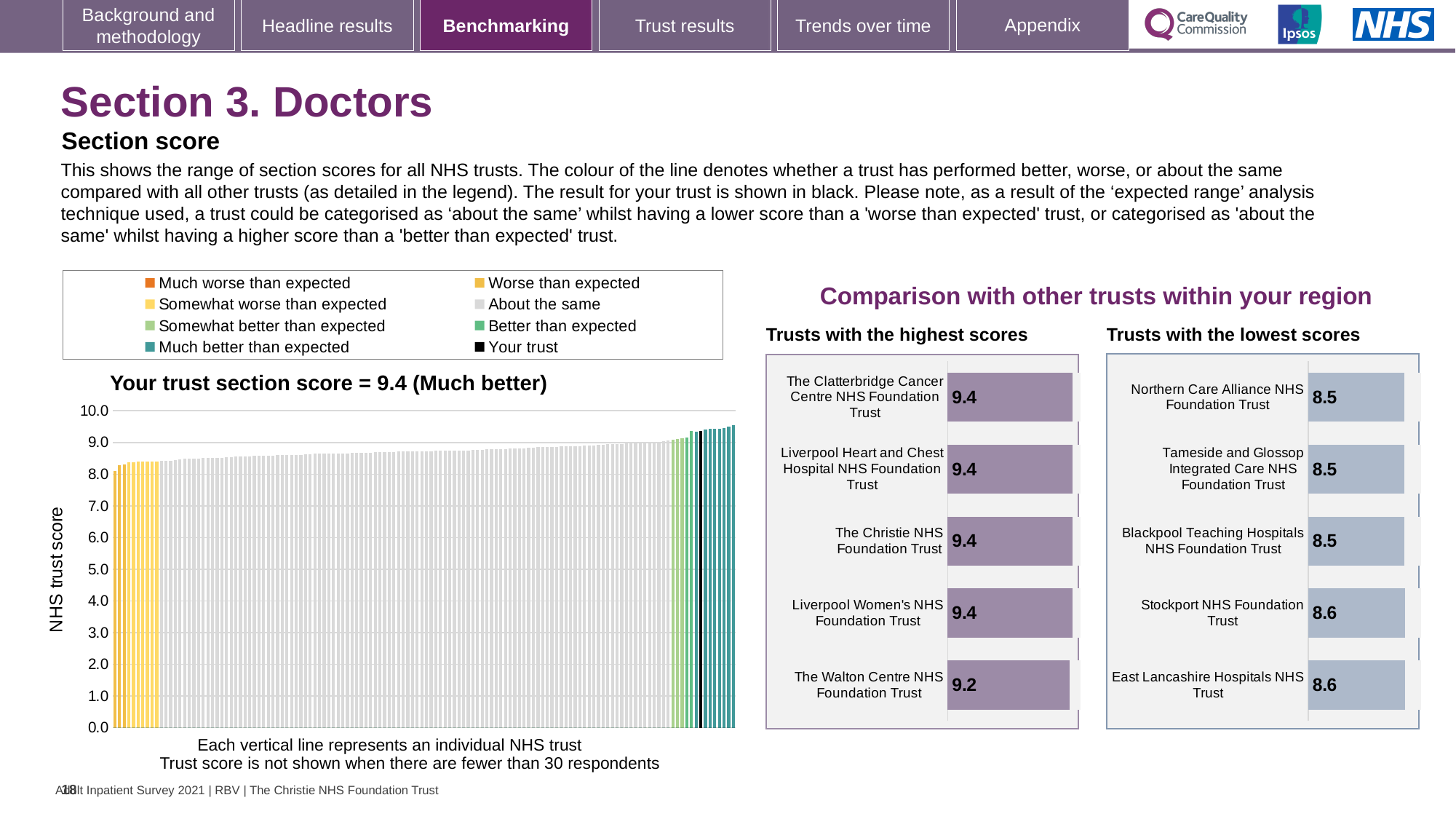
On the 'Trusts with the highest scores' chart, what is the difference between the score for The Clatterbridge Cancer Centre NHS Foundation Trust and The Walton Centre NHS Foundation Trust? 0.2 On the 'Trusts with the lowest scores' chart, what is the difference between the score for East Lancashire Hospitals NHS Trust and Tameside and Glossop Integrated Care NHS Foundation Trust? 0.1 On the 'Trusts with the highest scores' chart, what is the score for The Walton Centre NHS Foundation Trust? 9.2 On the 'Your trust section score' chart, do the trust scores rise or fall from left to right along the x axis? rise On the 'Your trust section score' chart, how many entries does the legend list? 8 On the 'Trusts with the highest scores' chart, how many trusts are shown? 5 On the 'Trusts with the lowest scores' chart, what is the score for Blackpool Teaching Hospitals NHS Foundation Trust? 8.5 On the 'Your trust section score' chart, is the value for your trust greater or less than 9.0? greater On the 'Your trust section score' chart, what kind of chart is it? bar chart On the 'Trusts with the lowest scores' chart, which has the larger score, Northern Care Alliance NHS Foundation Trust or Stockport NHS Foundation Trust? Stockport NHS Foundation Trust On the 'Your trust section score' chart, what is the section score for your trust? 9.4 On the 'Trusts with the highest scores' chart, which trust has the lowest score? The Walton Centre NHS Foundation Trust